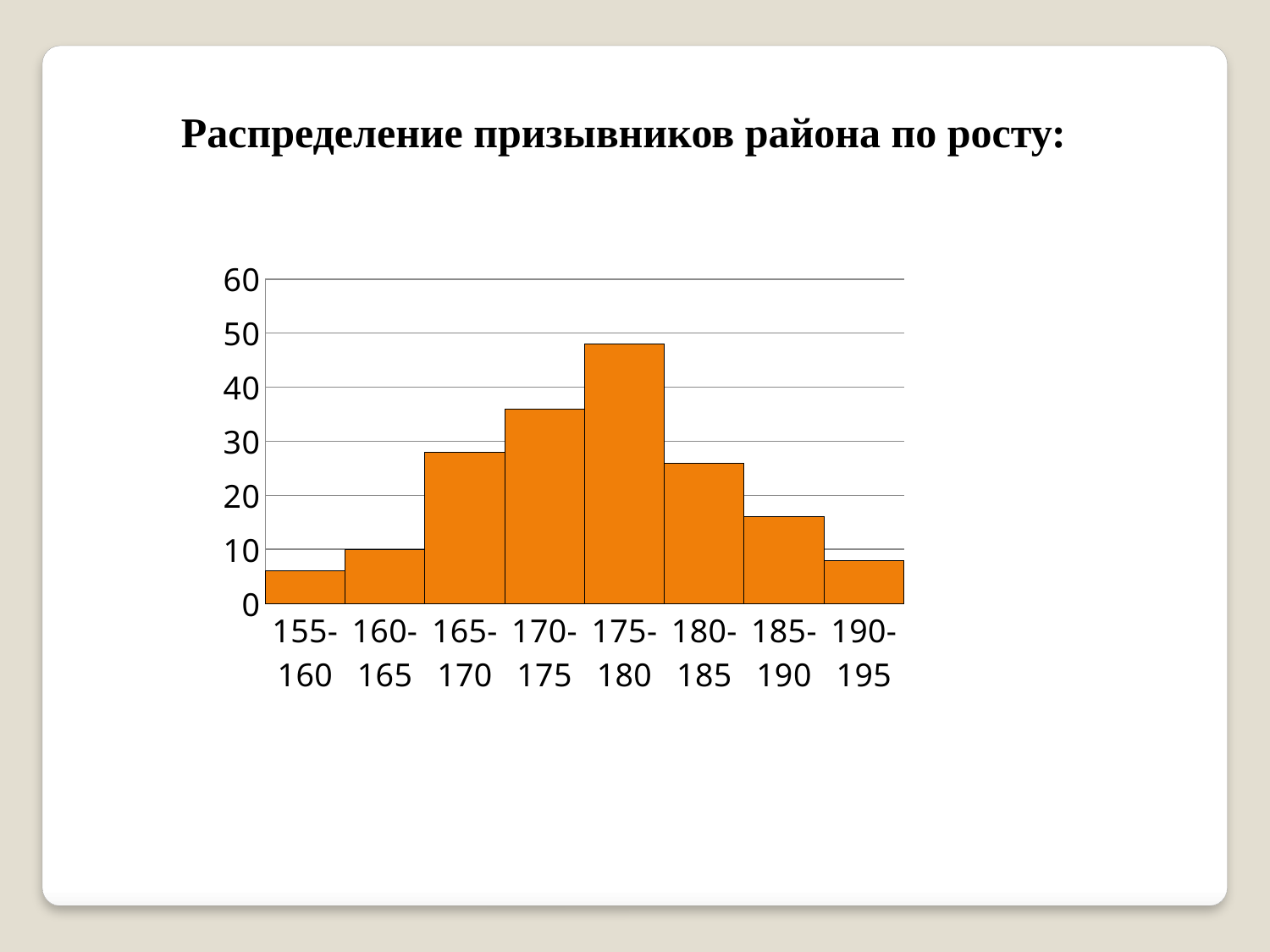
Is the value for the 170-175 interval greater or less than 30? greater Is the value for the 165-170 interval greater or less than 30? less What type of chart is shown on the slide? bar chart Which height interval has the lowest number of conscripts? 155-160 Which interval has a larger value, 170-175 or 180-185? 170-175 Is the value for the 175-180 interval greater or less than 40? greater Which height interval has the highest number of conscripts? 175-180 How many height intervals (categories) are shown on the x axis? 8 What is the title of the slide above the chart? Распределение призывников района по росту: What is the value for the 160-165 interval? 10